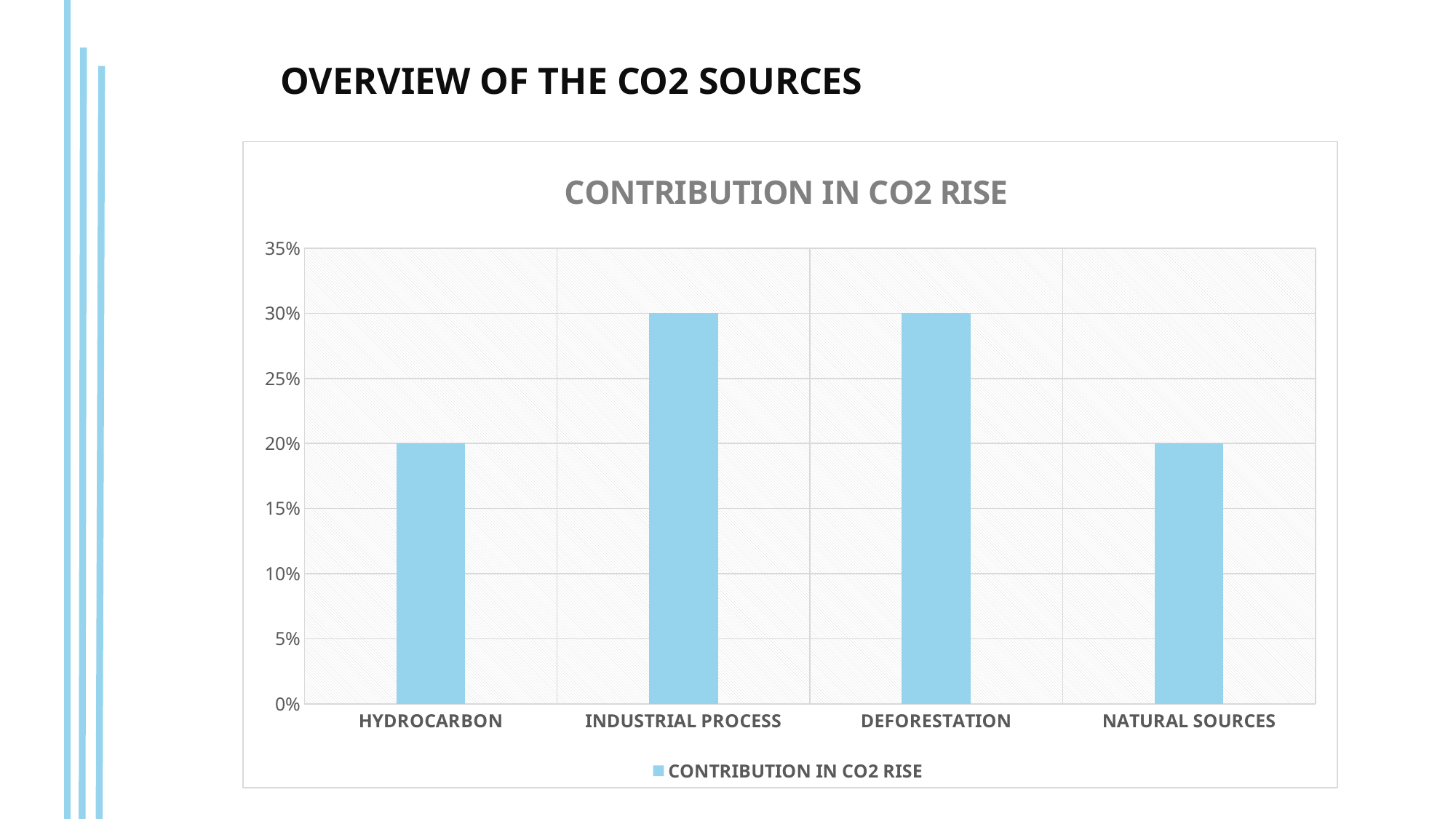
Is the value for Industrial Process greater or less than 25%? greater How many categories are shown on the x axis? 4 What is the value for Hydrocarbon? 20% Is the value for Hydrocarbon greater or less than 25%? less What is the value for Industrial Process? 30% What is the difference between the values for Deforestation and Natural Sources? 10% Which is larger, the value for Natural Sources or the value for Deforestation? Deforestation Which is larger, the value for Industrial Process or the value for Hydrocarbon? Industrial Process How many series does the legend list? 1 What kind of chart is shown? bar chart What is the value for Deforestation? 30% What is the value for Natural Sources? 20%